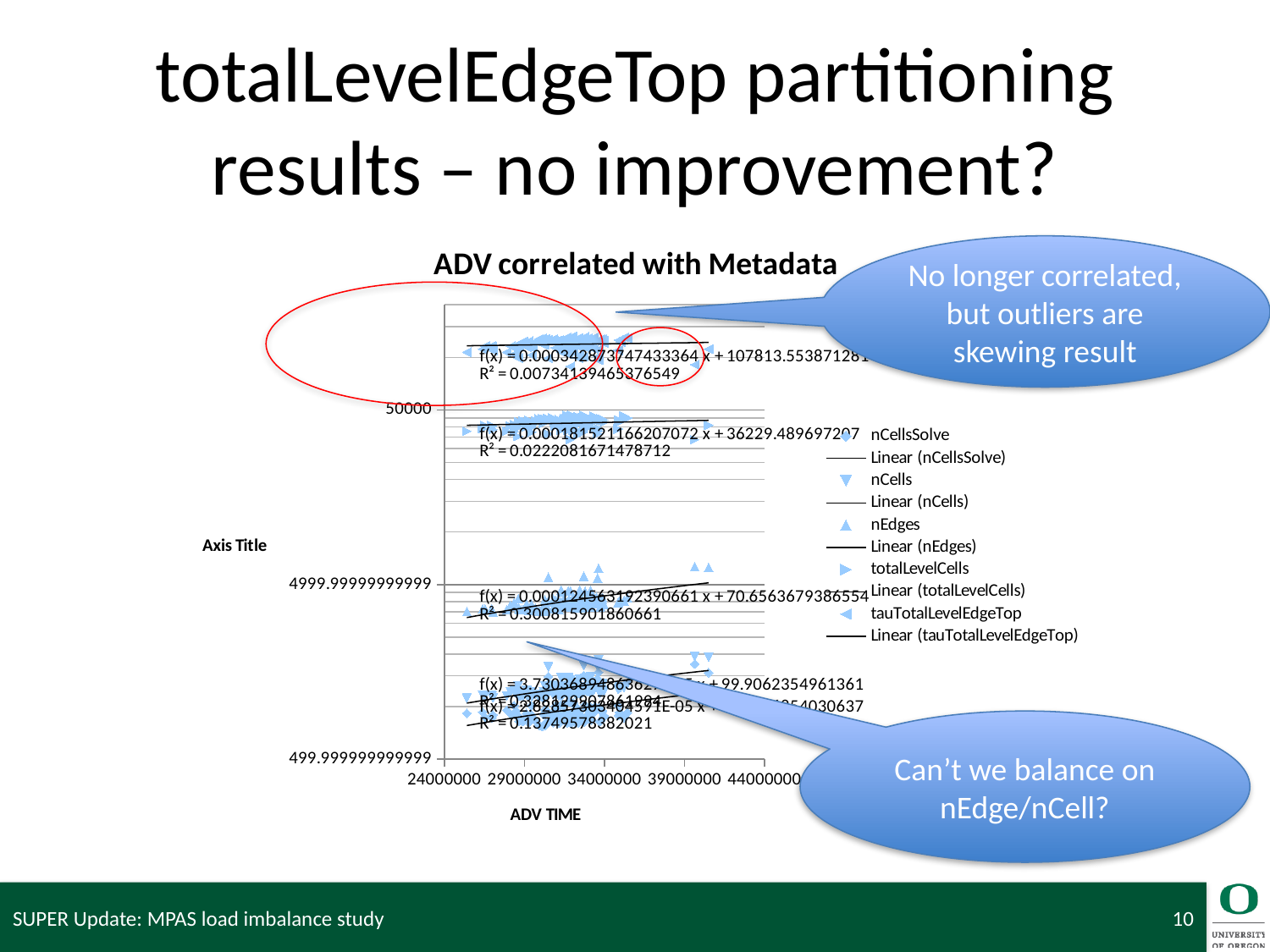
What R² value is printed for the trendline whose equation has intercept 70.6563679386554? 0.300815901860661 What R² value is printed for the trendline whose equation has intercept 36229.489697207? 0.0222081671478712 What R² value is printed for the topmost trendline in the chart? 0.00734139465376549 How many entries does the chart's legend list? 10 What is the title of the chart? ADV correlated with Metadata What kind of chart is shown on the slide? scatter chart Which printed R² value is larger: 0.300815901860661 or 0.13749578382021? 0.300815901860661 What is the lowest R² value printed on the chart? 0.00734139465376549 What is the label on the x axis of the chart? ADV TIME